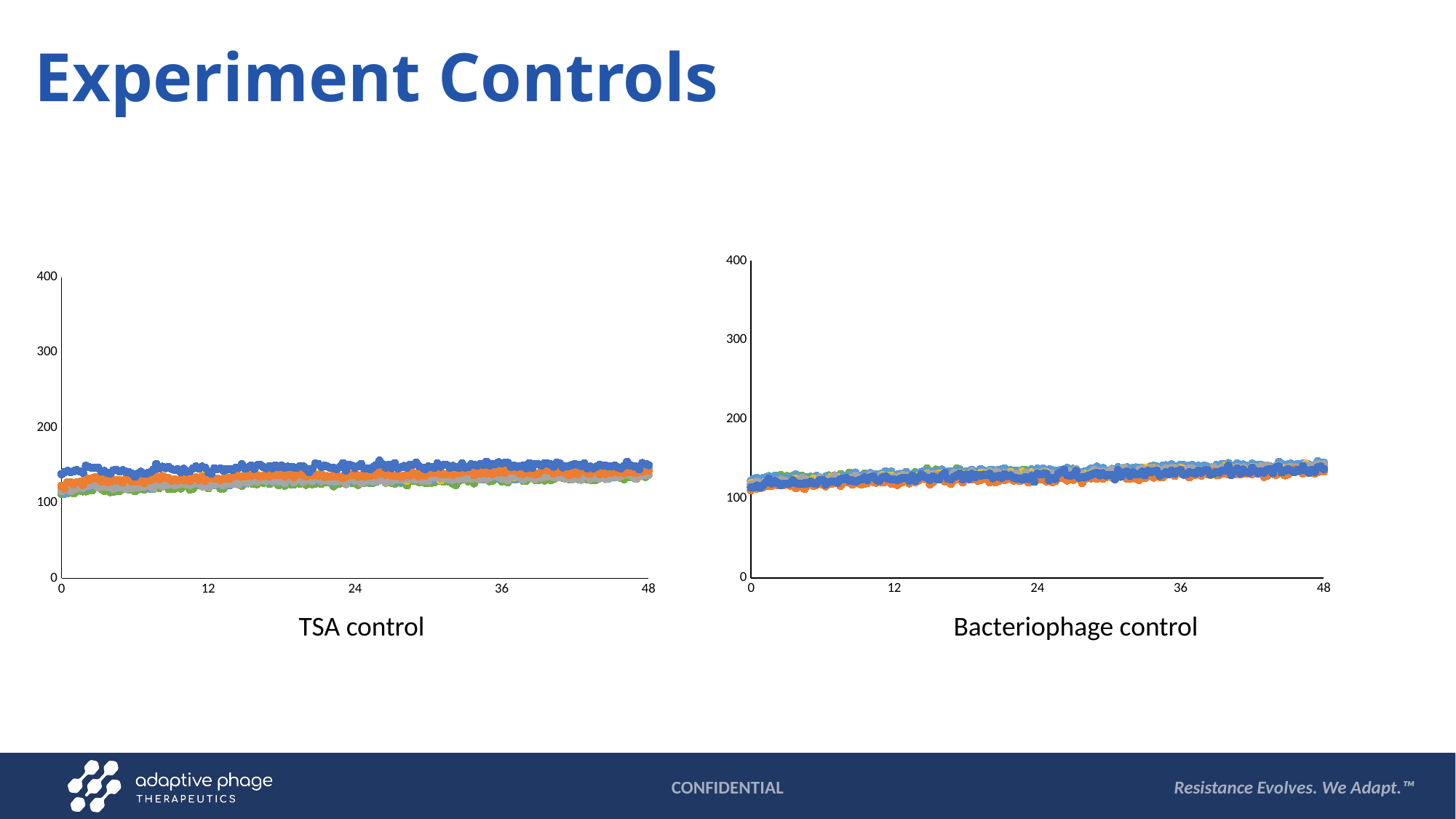
In the Bacteriophage control chart, do the plotted values generally rise or fall from x = 0 to x = 48? rise How many charts are shown on the slide? 2 What is the highest value shown on the x axis of the Bacteriophage control chart? 48 In the TSA control chart, are the plotted values at x = 48 greater or less than 200? less In the TSA control chart, are the plotted values at x = 24 greater or less than 100? greater In the Bacteriophage control chart, are the plotted values at x = 48 greater or less than 200? less What is the highest value shown on the y axis of the TSA control chart? 400 What kind of chart is the Bacteriophage control chart? scatter chart What kind of chart is the TSA control chart? scatter chart In the TSA control chart, do the plotted values generally rise or fall from x = 0 to x = 48? rise